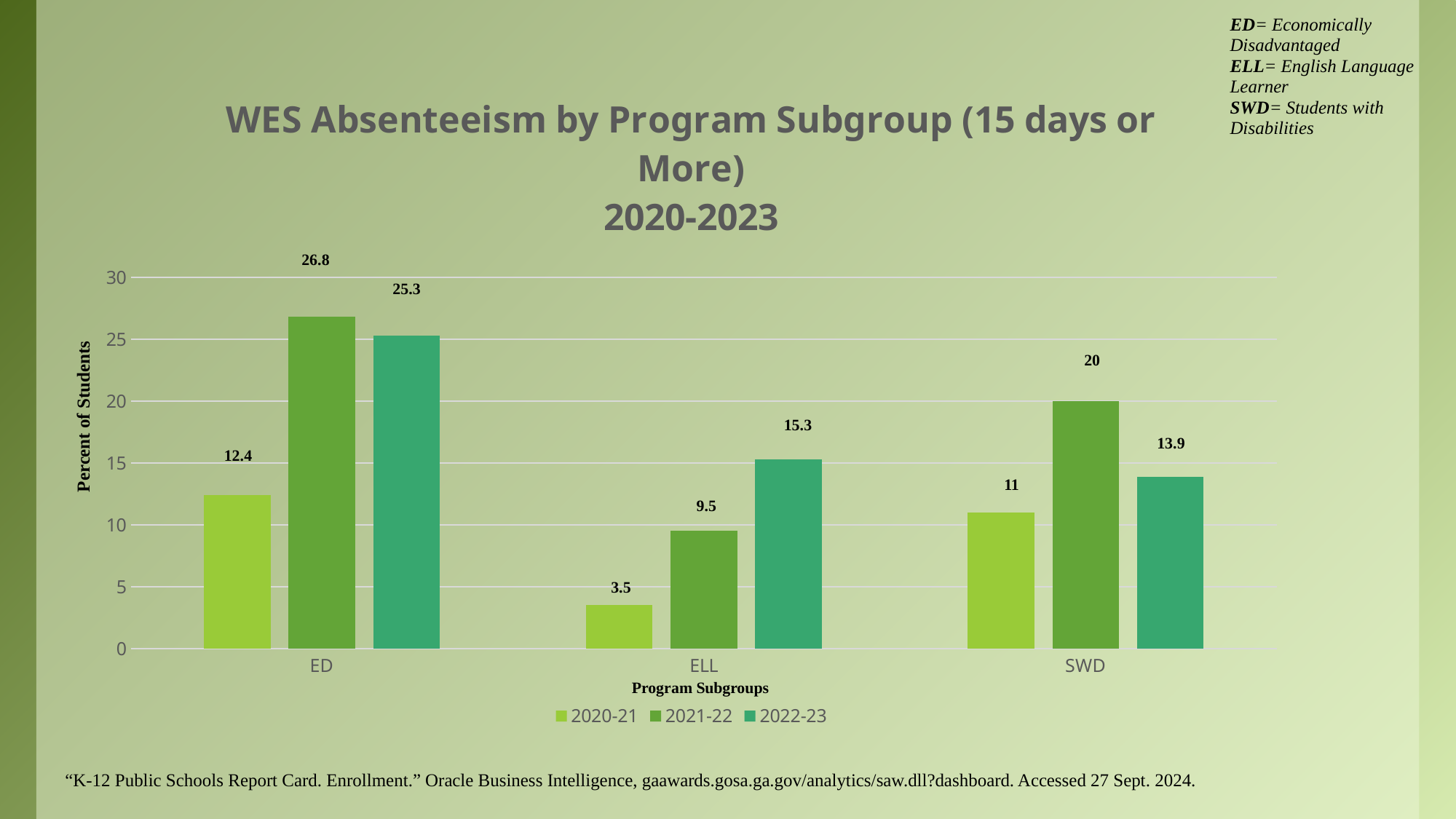
What is the value for ED in 2021-22? 26.8 What is the value for ELL in 2020-21? 3.5 Which program subgroup has the highest value in 2022-23? ED What is the difference between the 2021-22 and 2022-23 values for ED? 1.5 What is the value for SWD in 2022-23? 13.9 How many series does the legend list? 3 How many program subgroups are shown on the x axis? 3 Which is larger for SWD: the 2020-21 value or the 2022-23 value? 2022-23 Which program subgroup has the lowest value in 2020-21? ELL What kind of chart is shown on the slide? bar chart Is the value for ELL in 2021-22 greater or less than 10? less What is the label of the y axis? Percent of Students